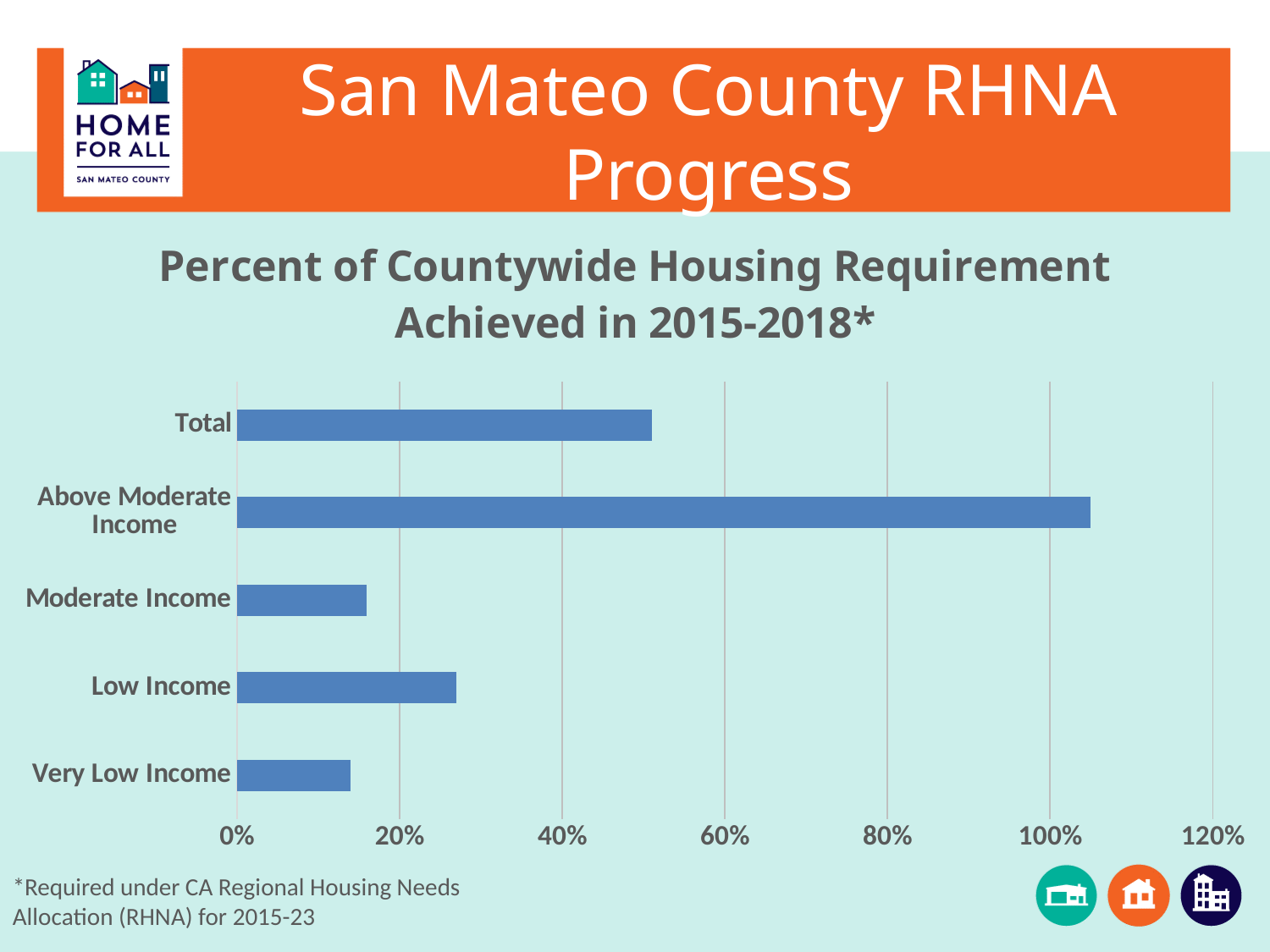
Which is larger, the value for Total or the value for Above Moderate Income? Above Moderate Income Is the value for Low Income greater or less than 20%? greater Is the value for Total greater or less than 40%? greater Is the value for Above Moderate Income greater or less than 100%? greater Which category has the highest percent of countywide housing requirement achieved? Above Moderate Income How many income categories are plotted on the chart? 5 Which is larger, the value for Low Income or the value for Very Low Income? Low Income What kind of chart is shown on the slide? Bar chart What is the title of the chart? Percent of Countywide Housing Requirement Achieved in 2015-2018*